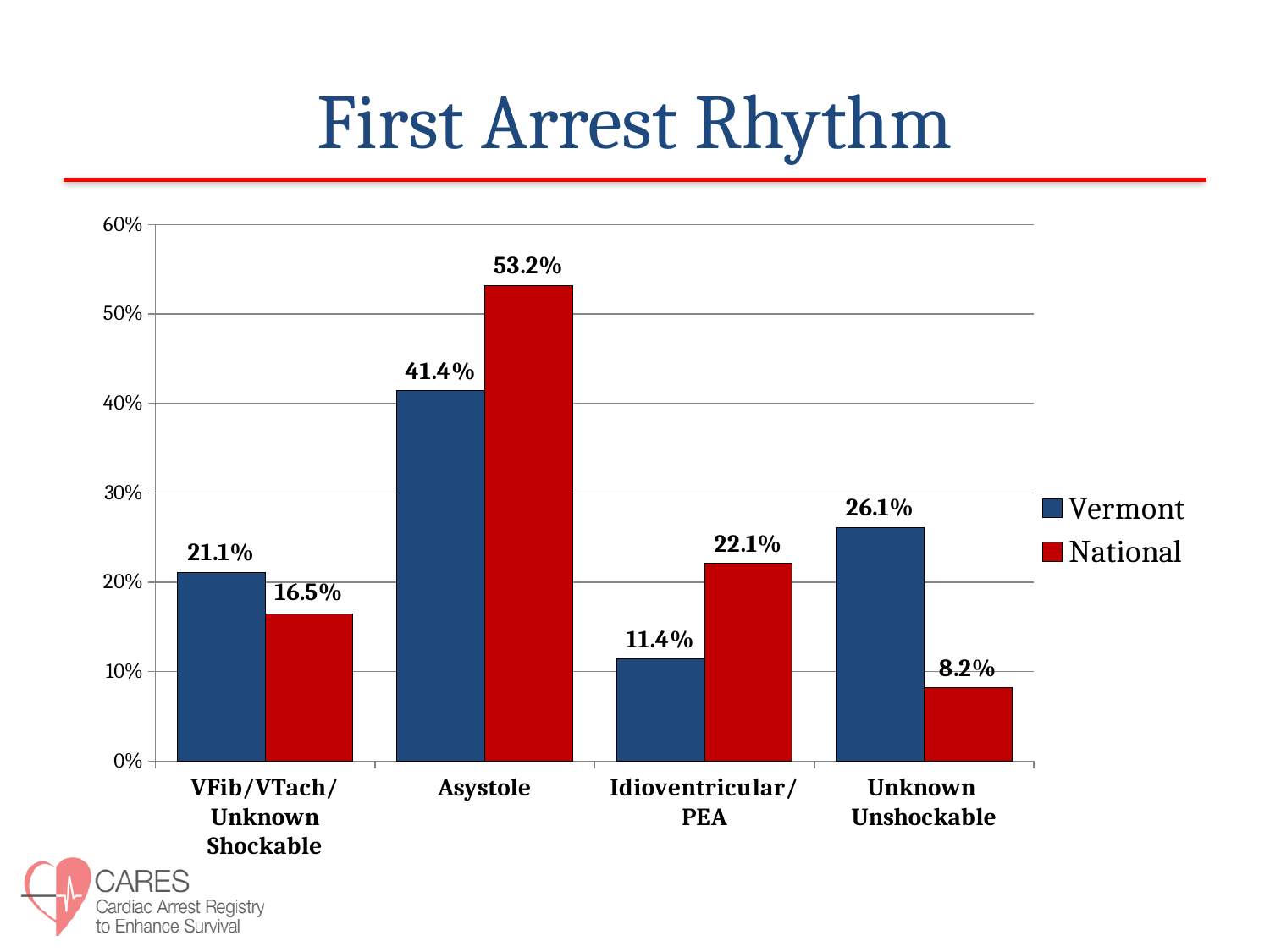
For VFib/VTach/Unknown Shockable, which is larger, the Vermont or the National value? Vermont How many series does the legend list? 2 What is the National value for Unknown Unshockable? 8.2% Which category has the highest National value? Asystole What is the Vermont value for Asystole? 41.4% What is the difference between the Vermont and National values for Unknown Unshockable? 17.9% What kind of chart is shown on the slide? Bar chart How many categories are shown on the x axis? 4 What is the title of the chart? First Arrest Rhythm What is the National value for Idioventricular/PEA? 22.1% What is the difference between the National and Vermont values for Asystole? 11.8% Which category has the lowest Vermont value? Idioventricular/PEA